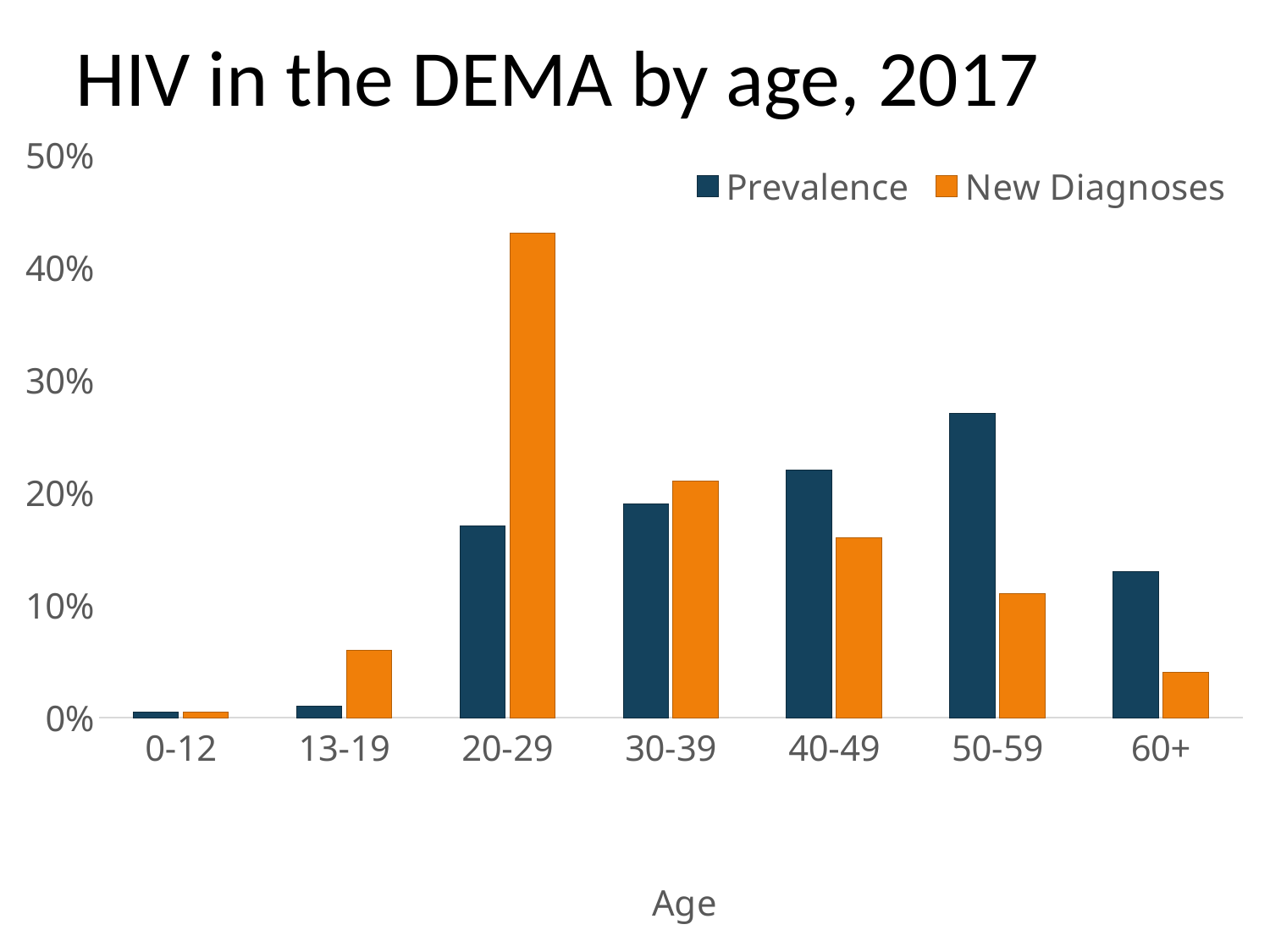
Is the New Diagnoses value for 60+ greater or less than 10%? less How many series does the legend list? 2 Which age group has the lowest New Diagnoses value? 0-12 How many age categories are shown on the x axis? 7 What is the title of the chart? HIV in the DEMA by age, 2017 What type of chart is shown on the slide? Bar chart Is the Prevalence value for 50-59 greater or less than 20%? greater For the 50-59 age group, which is larger: Prevalence or New Diagnoses? Prevalence Is the New Diagnoses value for 20-29 greater or less than 40%? greater Which age group has the highest New Diagnoses value? 20-29 Which age group has the highest Prevalence value? 50-59 For the 20-29 age group, which is larger: Prevalence or New Diagnoses? New Diagnoses